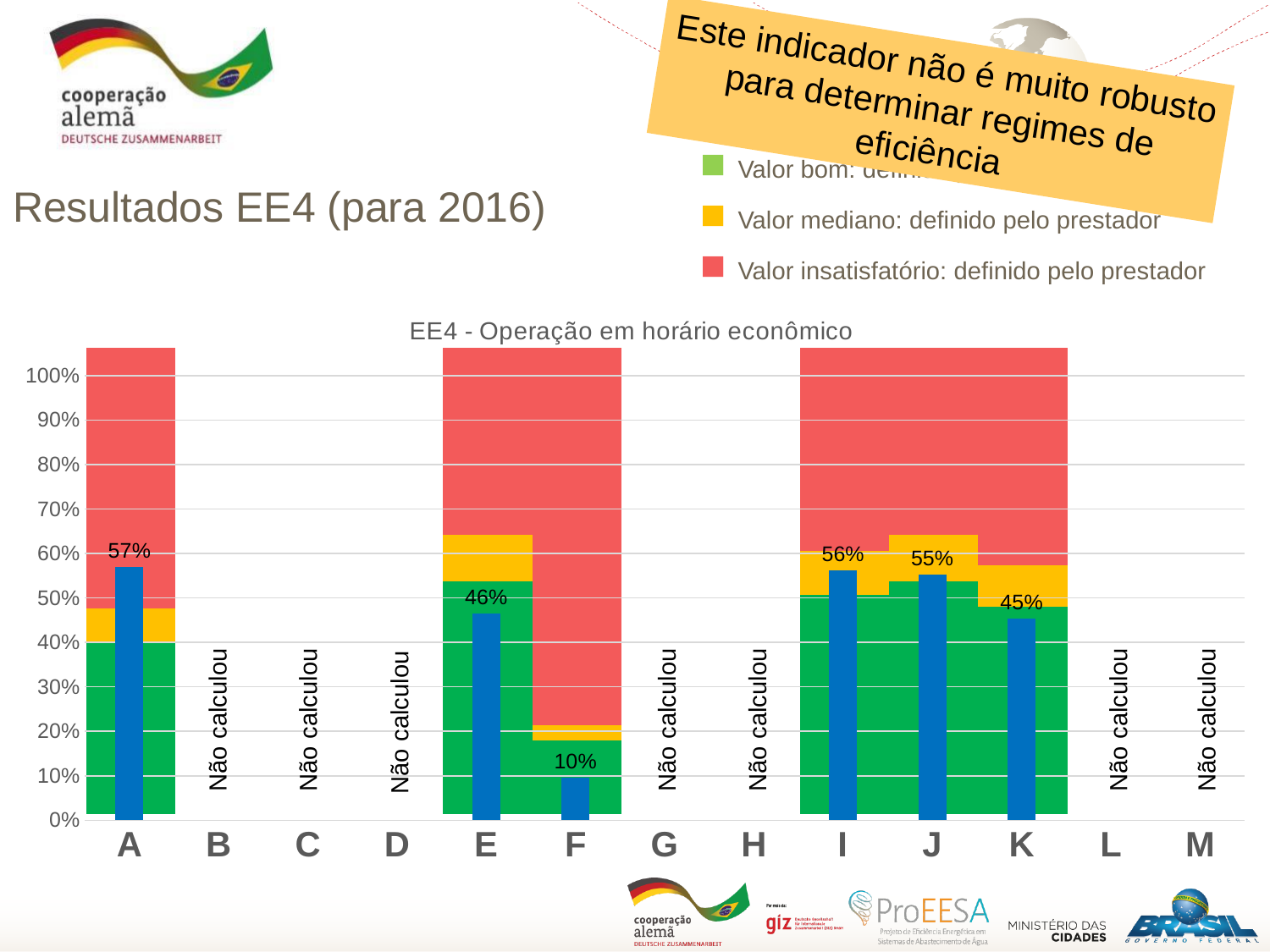
What is the value shown for utility A in the EE4 chart? 57% Which has the larger value, I or J? I Which utility has the highest value in the chart? A How many utilities (categories) are listed along the x axis? 13 How many utilities are marked as "Não calculou"? 7 What kind of chart is shown on the slide? Bar chart What is the value shown for utility F? 10% What is the difference between the values for A and K? 12 percentage points Is the value for E greater or less than 50%? less Which utility has the lowest plotted value in the chart? F What is the value shown for utility K? 45% What is the title of the chart? EE4 - Operação em horário econômico